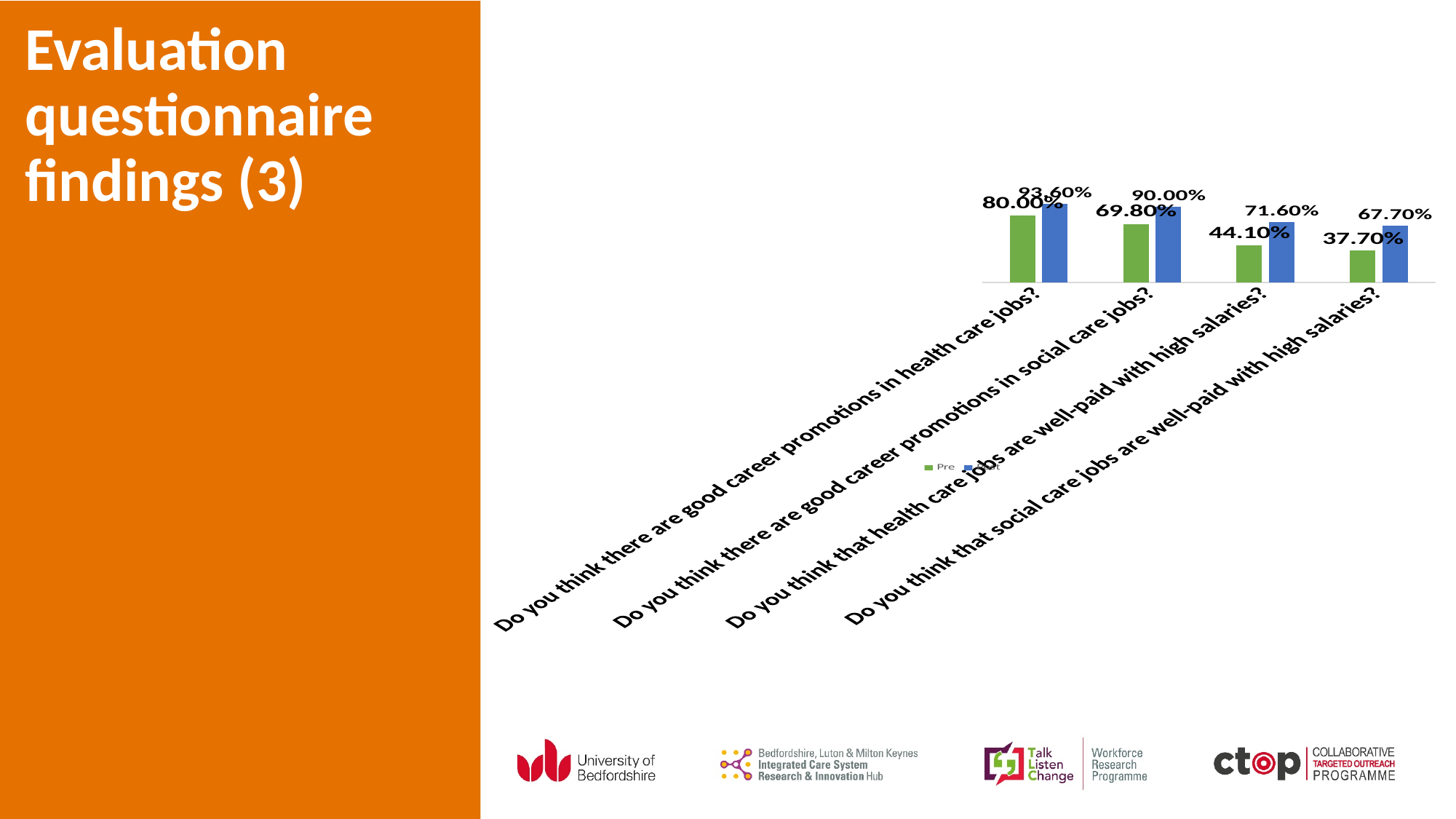
What is the Post value for "Do you think that social care jobs are well-paid with high salaries?"? 67.70% What is the difference between the Post and Pre values for "Do you think there are good career promotions in social care jobs?"? 20.20% How many questions (categories) are shown on the chart? 4 What is the Pre value for "Do you think there are good career promotions in health care jobs?"? 80.00% Which is larger for "Do you think that social care jobs are well-paid with high salaries?": the Pre value or the Post value? Post What is the Post value for "Do you think there are good career promotions in social care jobs?"? 90.00% Which question has the highest Post value? Do you think there are good career promotions in health care jobs? What is the difference between the Post and Pre values for "Do you think that health care jobs are well-paid with high salaries?"? 27.50% What kind of chart is shown on the slide? Bar chart What is the Pre value for "Do you think that health care jobs are well-paid with high salaries?"? 44.10% Which question has the lowest Pre value? Do you think that social care jobs are well-paid with high salaries? How many series does the legend list? 2